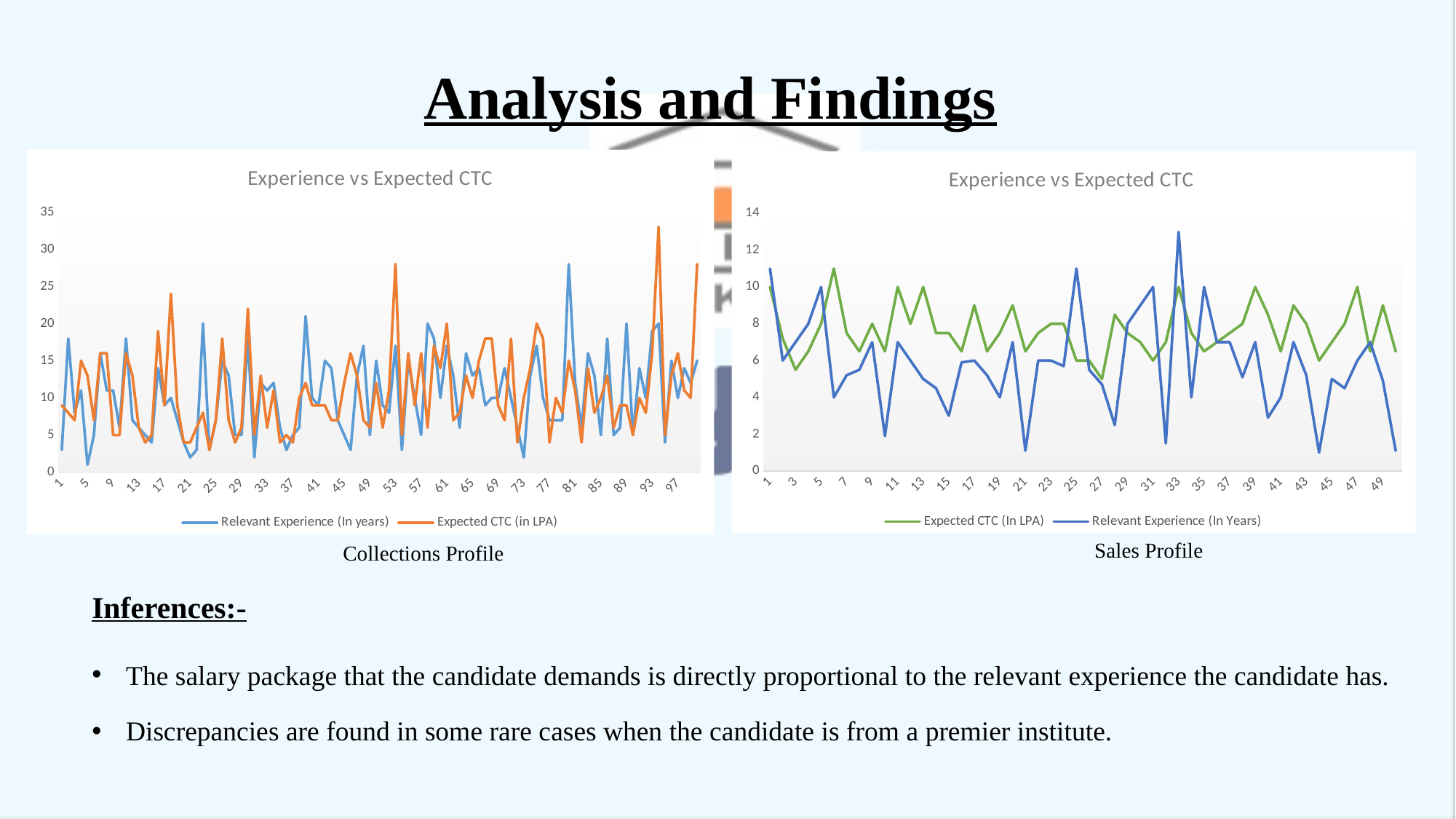
In the Sales Profile chart, which series is drawn in green? Expected CTC (In LPA) How many series does the legend of the Collections Profile chart list? 2 In the Sales Profile chart, which series reaches the highest value anywhere on the chart, Expected CTC or Relevant Experience? Relevant Experience (In Years) How many series does the legend of the Sales Profile chart list? 2 In the Sales Profile chart, is the Relevant Experience value at point 33 greater or less than 12? greater In the Collections Profile chart, which series reaches the highest value anywhere on the chart, Relevant Experience or Expected CTC? Expected CTC (in LPA) In the Sales Profile chart, is the Relevant Experience value at point 21 greater or less than 2? less What kind of chart is the Sales Profile chart on the right? Line chart What is the title of the Collections Profile chart on the left? Experience vs Expected CTC What kind of chart is the Collections Profile chart on the left? Line chart